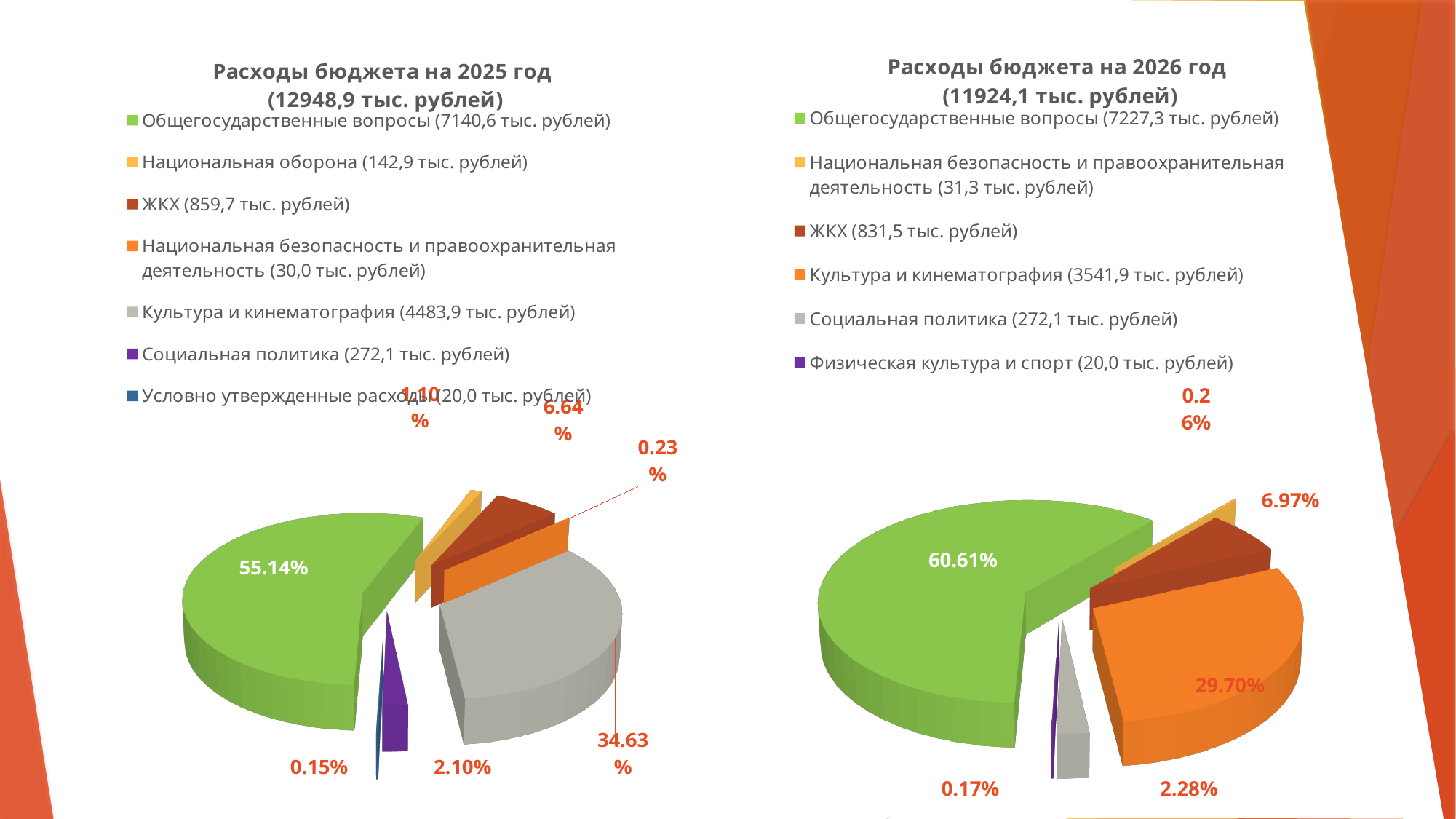
In the 'Расходы бюджета на 2025 год' chart, what share of the pie does 'Общегосударственные вопросы' take? 55.14% How many categories does the legend of the 'Расходы бюджета на 2026 год' chart list? 6 What kind of chart is used for 'Расходы бюджета на 2025 год'? pie chart How many categories does the legend of the 'Расходы бюджета на 2025 год' chart list? 7 In the 'Расходы бюджета на 2025 год' chart, which category has the smallest share? Условно утвержденные расходы In the 'Расходы бюджета на 2026 год' chart, what share does 'Общегосударственные вопросы' take? 60.61% Which is larger: the share of 'ЖКХ' in the 2025 chart or the share of 'ЖКХ' in the 2026 chart? 2026 chart (6.97%) In the 'Расходы бюджета на 2026 год' chart, which category has the largest share? Общегосударственные вопросы In the 'Расходы бюджета на 2025 год' chart, what share does 'Культура и кинематография' take? 34.63% In the 'Расходы бюджета на 2026 год' chart, what amount is shown in the legend for 'Социальная политика'? 272,1 тыс. рублей In the 'Расходы бюджета на 2025 год' chart, what amount is shown in the legend for 'ЖКХ'? 859,7 тыс. рублей